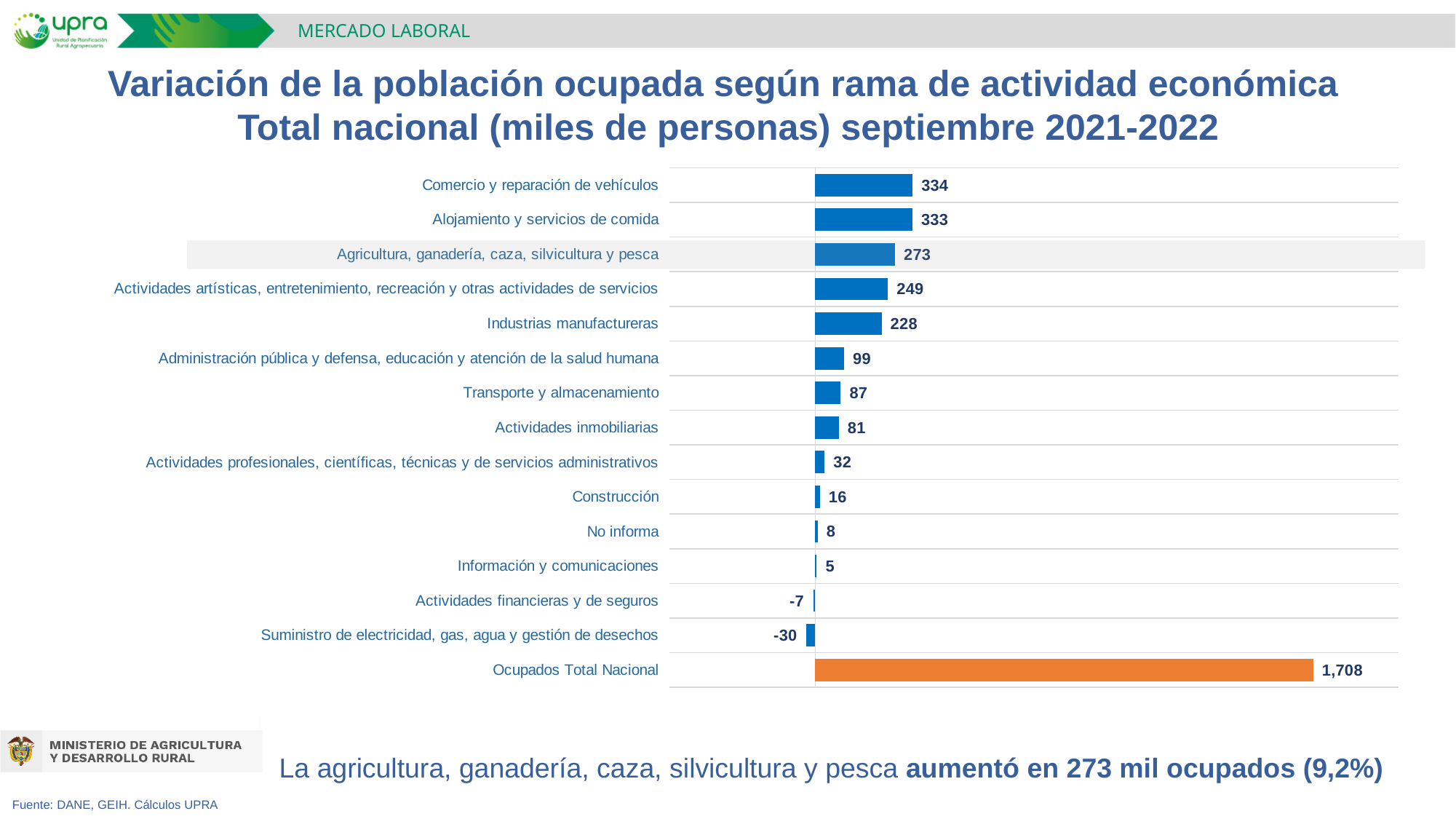
What kind of chart is shown on the slide? Bar chart Which category has the highest value? Ocupados Total Nacional How many categories have a negative value? 2 What is the value for Agricultura, ganadería, caza, silvicultura y pesca? 273 What is the value for Suministro de electricidad, gas, agua y gestión de desechos? -30 How many categories are shown in the chart? 15 What is the difference between the values for Comercio y reparación de vehículos and Industrias manufactureras? 106 What is the value for Ocupados Total Nacional? 1,708 What colour is the bar for Ocupados Total Nacional? Orange Which category has the lowest value? Suministro de electricidad, gas, agua y gestión de desechos Which is larger, the value for Transporte y almacenamiento or the value for Construcción? Transporte y almacenamiento What is the value for Industrias manufactureras? 228